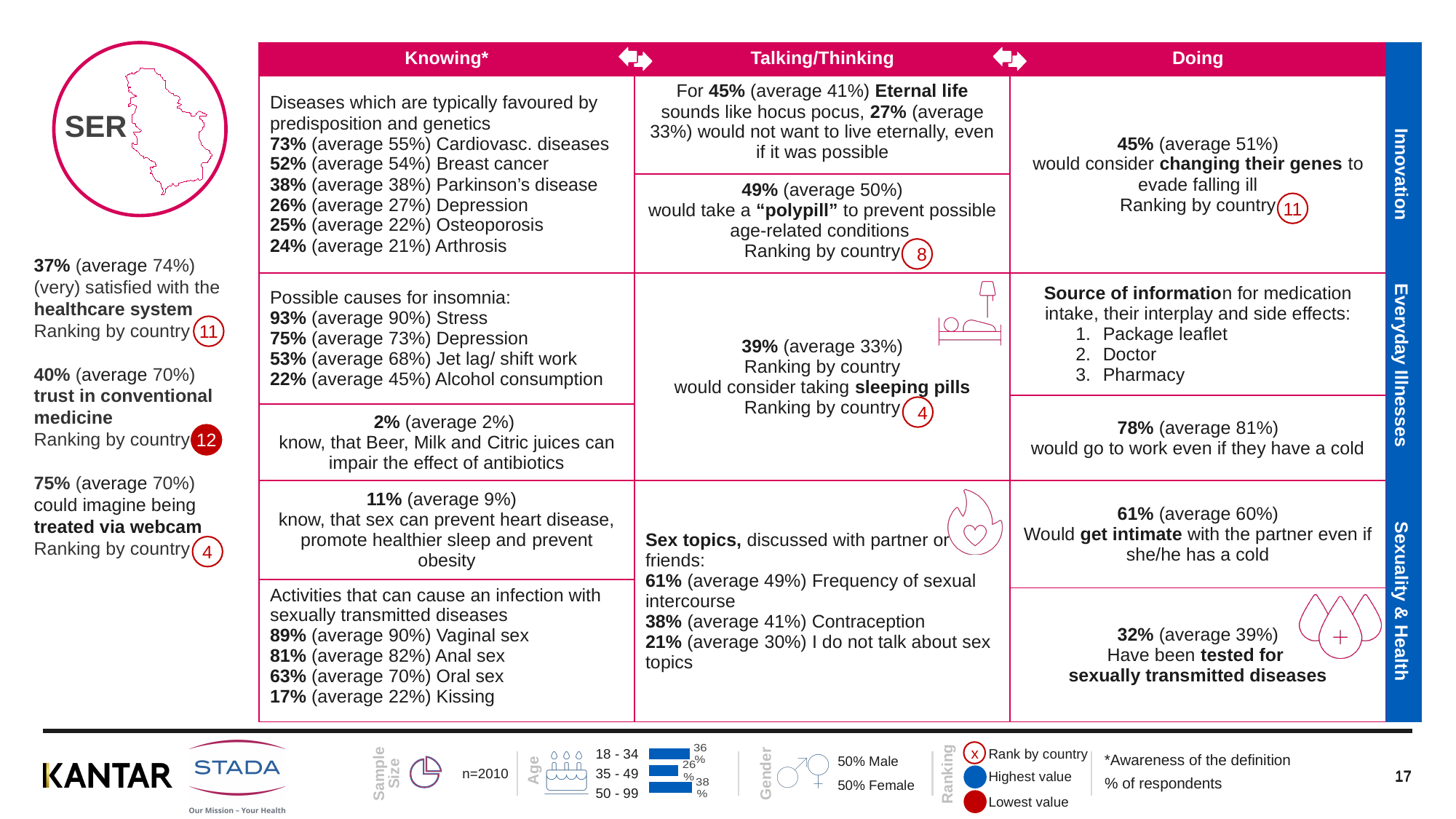
What is the sample size (n) shown next to the Sample Size icon at the bottom of the slide? n=2010 In the Age bar chart at the bottom of the slide, which age group has the lowest value? 35 - 49 How many age groups are shown in the Age bar chart at the bottom of the slide? 3 In the Age bar chart at the bottom of the slide, what is the difference between the 50 - 99 group and the 35 - 49 group? 12% In the Age bar chart at the bottom of the slide, which age group has the highest value? 50 - 99 What kind of chart is the small Age chart at the bottom of the slide? bar chart In the Age bar chart at the bottom of the slide, what is the value for the 35 - 49 group? 26% In the Age bar chart at the bottom of the slide, what is the value for the 18 - 34 group? 36% In the Age bar chart at the bottom of the slide, what is the value for the 50 - 99 group? 38% In the Age bar chart at the bottom of the slide, what is the difference between the 18 - 34 group and the 35 - 49 group? 10% In the Age bar chart at the bottom of the slide, which is larger: the 18 - 34 group or the 35 - 49 group? 18 - 34